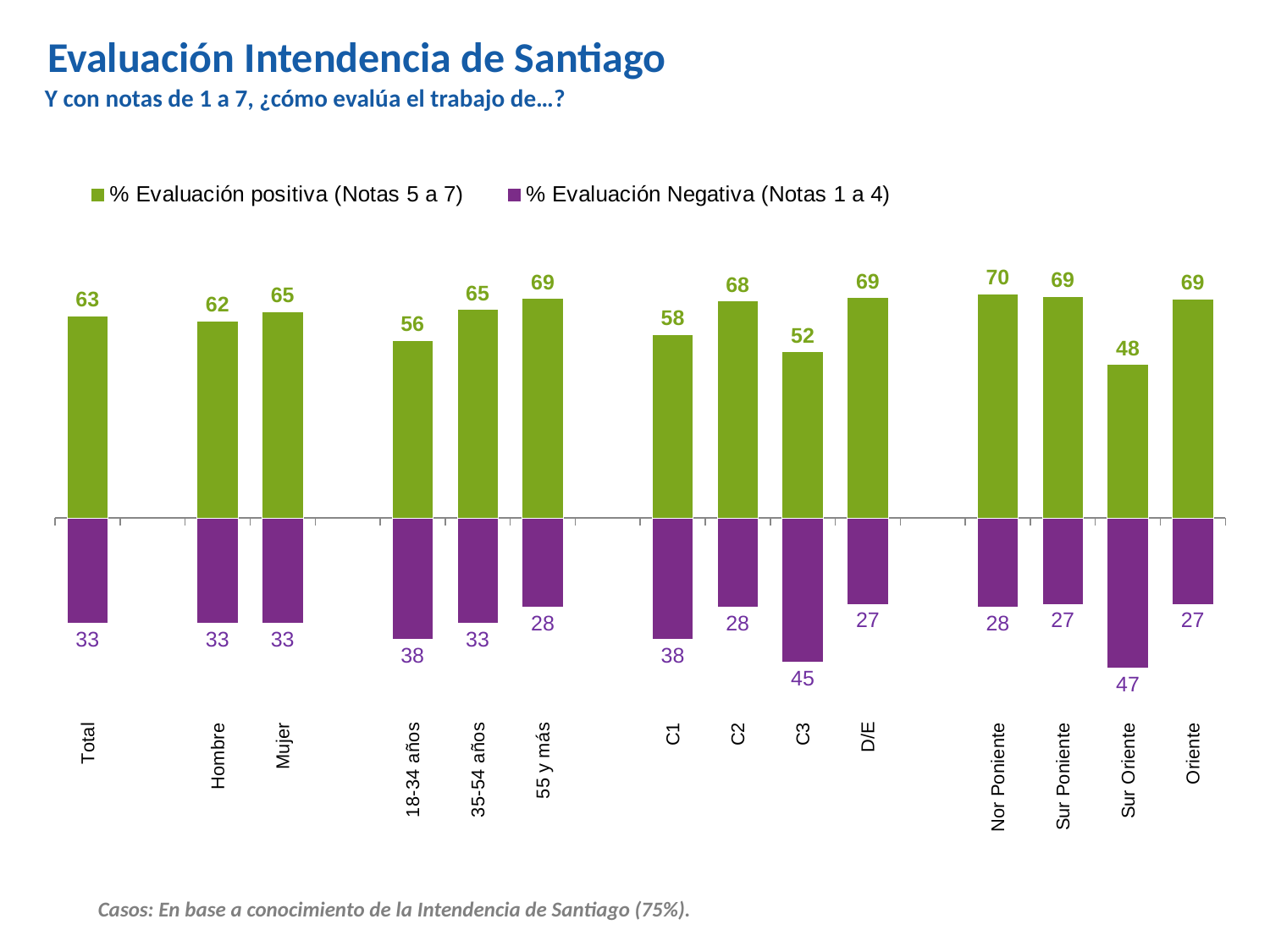
What colour are the bars for % Evaluación Negativa (Notas 1 a 4)? Purple Which has a higher % Evaluación positiva (Notas 5 a 7), C2 or C3? C2 Which category has the highest % Evaluación Negativa (Notas 1 a 4)? Sur Oriente What kind of chart is shown on the slide? Bar chart What is the % Evaluación Negativa (Notas 1 a 4) value for C3? 45 Which category has the highest % Evaluación positiva (Notas 5 a 7)? Nor Poniente What is the difference between the % Evaluación positiva values for Mujer and Hombre? 3 How many series does the legend list? 2 What is the % Evaluación positiva (Notas 5 a 7) value for Total? 63 What is the % Evaluación positiva (Notas 5 a 7) value for 18-34 años? 56 How many categories are shown on the x axis of the chart? 14 Which category has the lowest % Evaluación positiva (Notas 5 a 7)? Sur Oriente